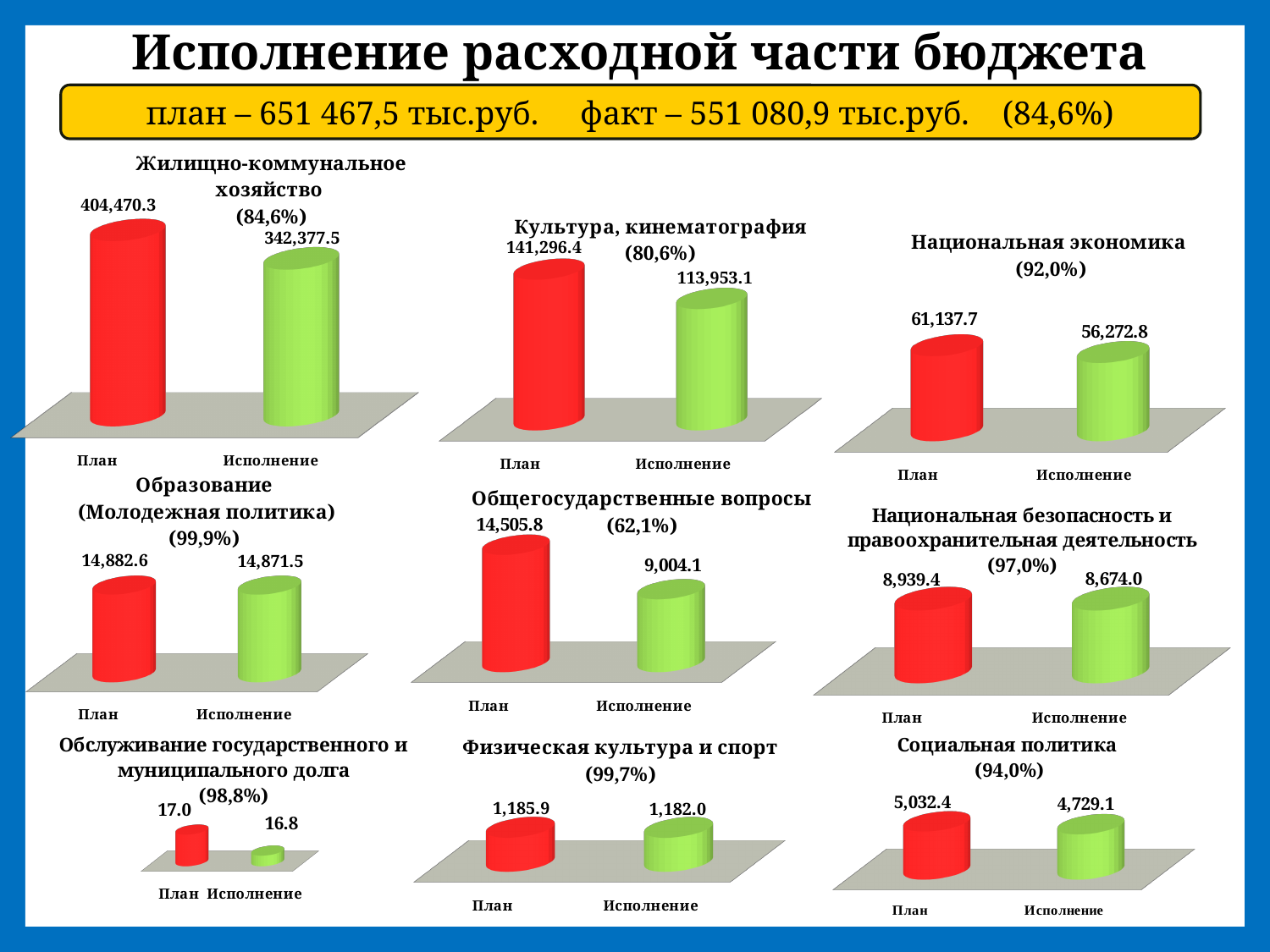
What colour is the План bar in the chart titled "Социальная политика"? Red What percentage is shown in the title of the chart "Образование (Молодежная политика)"? 99,9% In the chart titled "Жилищно-коммунальное хозяйство", what is the value for План? 404,470.3 In the chart titled "Обслуживание государственного и муниципального долга", which category has the lowest value? Исполнение What type of chart is used for "Национальная безопасность и правоохранительная деятельность"? Bar chart In the chart titled "Социальная политика", what is the difference between План and Исполнение? 303.3 In the chart titled "Культура, кинематография", what is the value for Исполнение? 113,953.1 In the chart titled "Национальная экономика", what is the value for План? 61,137.7 In the chart titled "Общегосударственные вопросы", which bar is taller, План or Исполнение? План In the chart titled "Жилищно-коммунальное хозяйство", what is the difference between План and Исполнение? 62,092.8 How many bars are shown in the chart titled "Физическая культура и спорт"? 2 In the chart titled "Общегосударственные вопросы", what is the value for Исполнение? 9,004.1